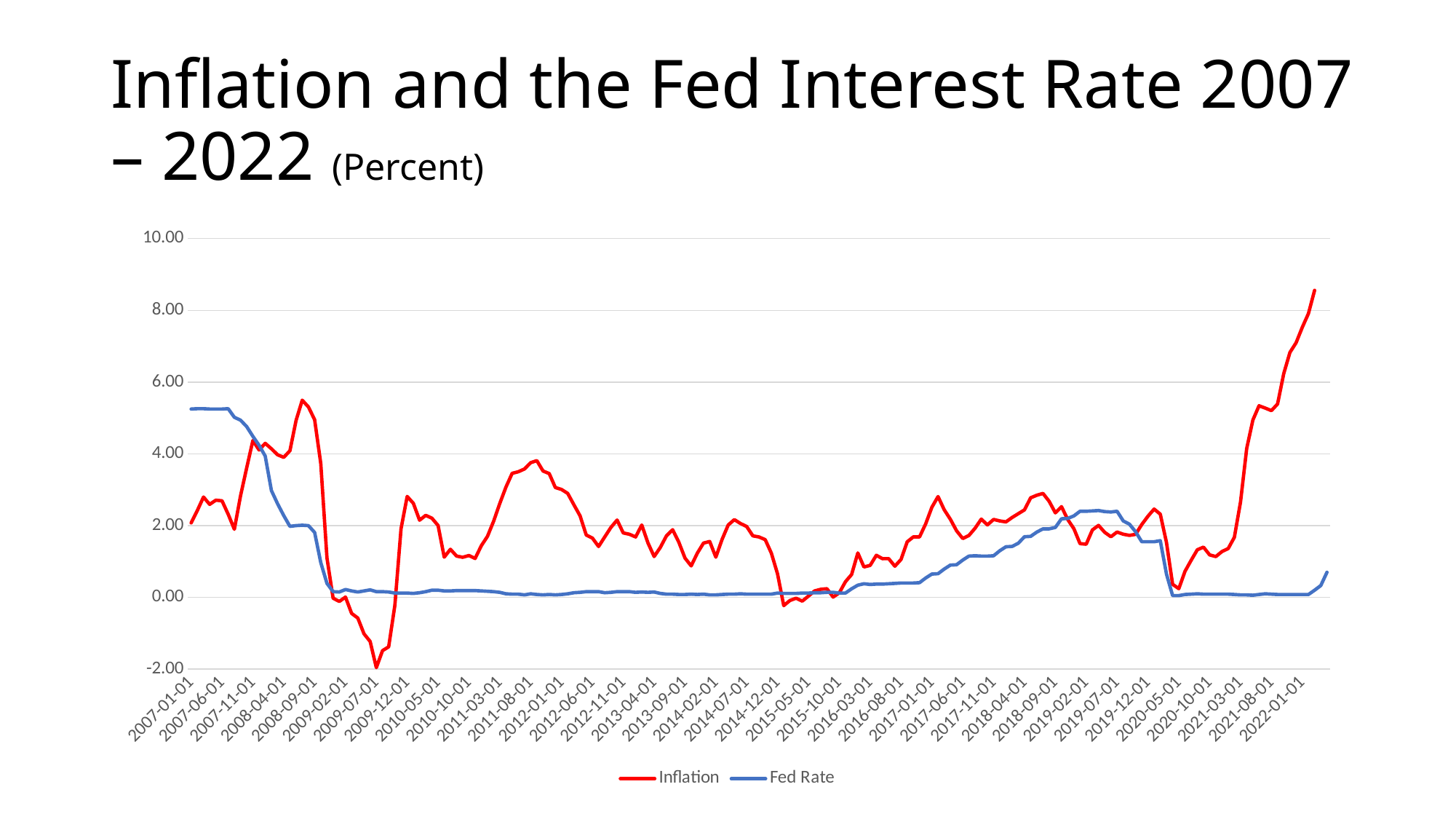
What kind of chart is shown on the slide? Line chart Which series reaches the highest value anywhere on the chart? Inflation What is the title of the chart? Inflation and the Fed Interest Rate 2007 – 2022 (Percent) Which series is drawn in red? Inflation Is the Fed Rate value at 2007-01-01 greater or less than 4.00? greater Does the Fed Rate rise or fall between 2007-01-01 and 2009-02-01? fall At 2007-01-01, which series has the higher value, Inflation or Fed Rate? Fed Rate Is the Inflation value at 2009-07-01 greater or less than 0.00? less At 2022-01-01, which series has the higher value, Inflation or Fed Rate? Inflation How many series does the legend list? 2 Is the Inflation value at 2022-01-01 greater or less than 6.00? greater